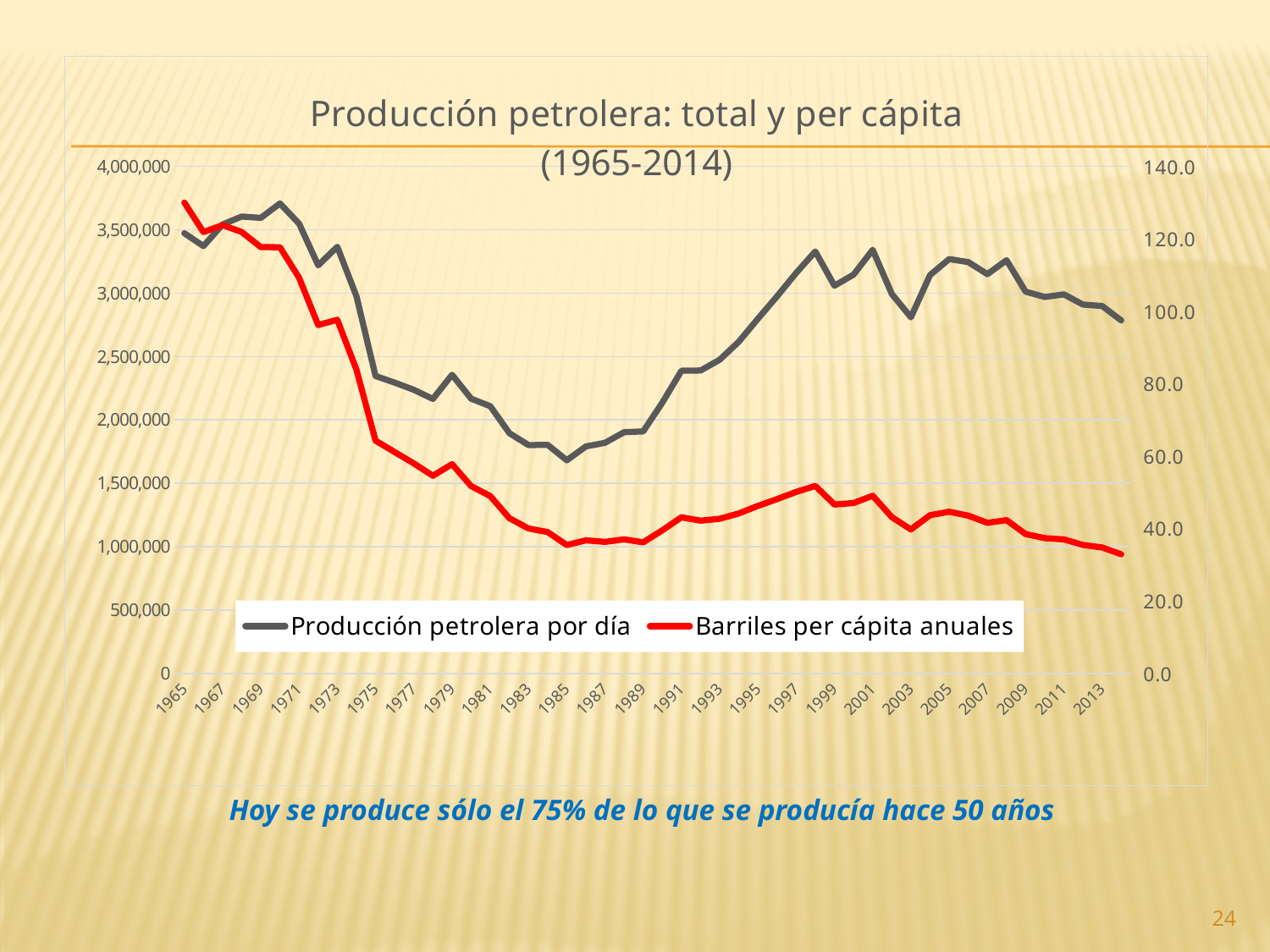
Which is larger for 'Producción petrolera por día': the value in 1965 or the value in 1985? 1965 Is the value of 'Producción petrolera por día' in 1985 greater or less than 2,000,000? less How many series does the legend list? 2 What is the title of the chart? Producción petrolera: total y per cápita (1965-2014) Is the value of 'Barriles per cápita anuales' in 1965 greater or less than 120.0? greater In which year does the 'Producción petrolera por día' line reach its lowest point? 1985 Is the value of 'Barriles per cápita anuales' in 2013 greater or less than 40.0? less Does the 'Barriles per cápita anuales' line rise or fall between 1965 and 1985? fall In which year is the 'Barriles per cápita anuales' line at its highest? 1965 Which series is drawn in red? Barriles per cápita anuales What kind of chart is shown on the slide? Line chart